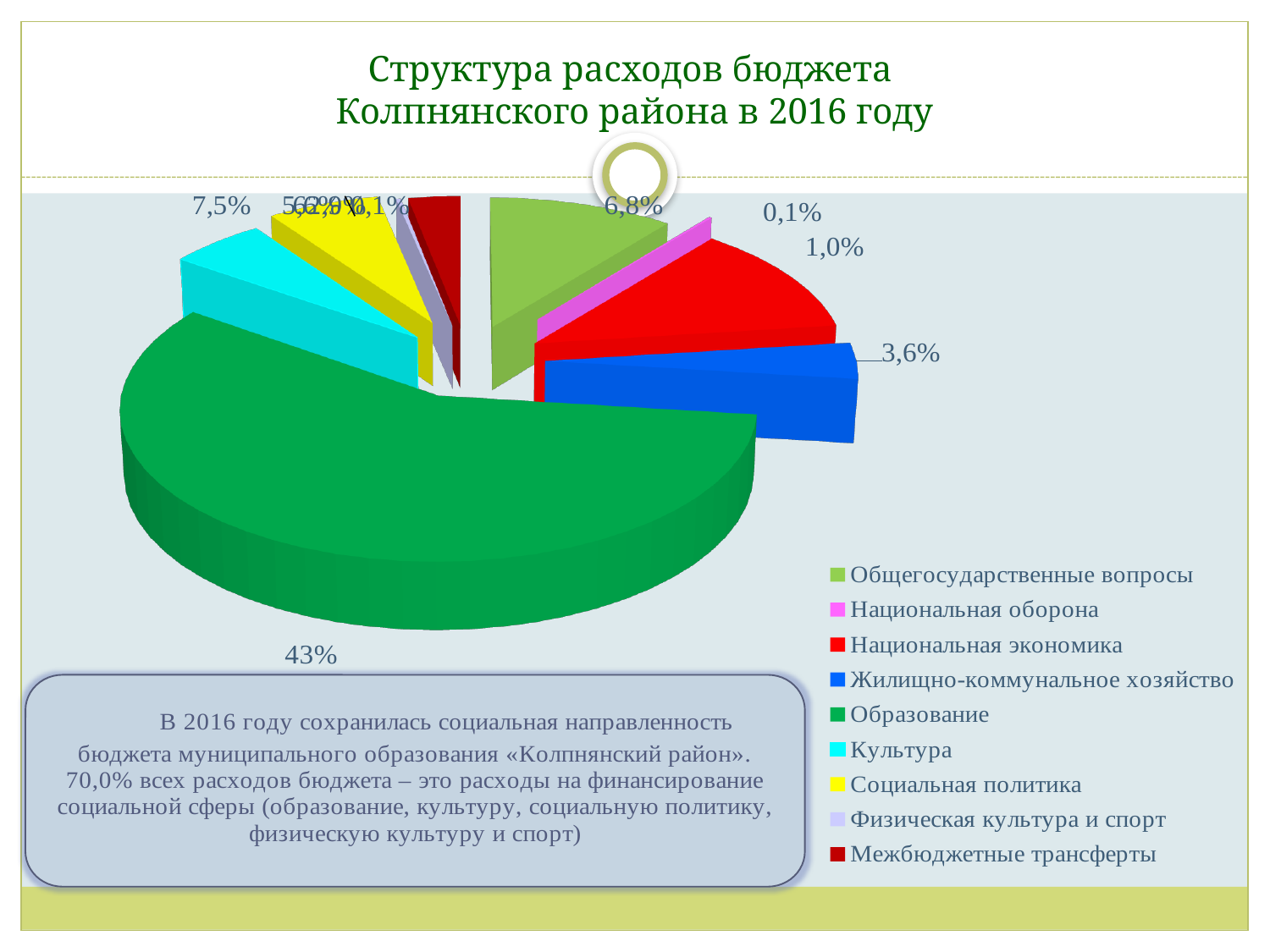
What is the difference between the shares for Образование and Культура? 35,5% What is the value shown for Жилищно-коммунальное хозяйство? 3,6% What share of the budget expenditure goes to Образование? 43% Which is larger, the share for Жилищно-коммунальное хозяйство or for Общегосударственные вопросы? Общегосударственные вопросы What kind of chart is shown on the slide? pie chart How many categories does the legend list? 9 What is the value shown for Культура? 7,5% What is the value shown for Общегосударственные вопросы? 6,8% Which category has the largest slice of the pie? Образование What is the title of the chart? Структура расходов бюджета Колпнянского района в 2016 году What colour is the slice for Образование? green